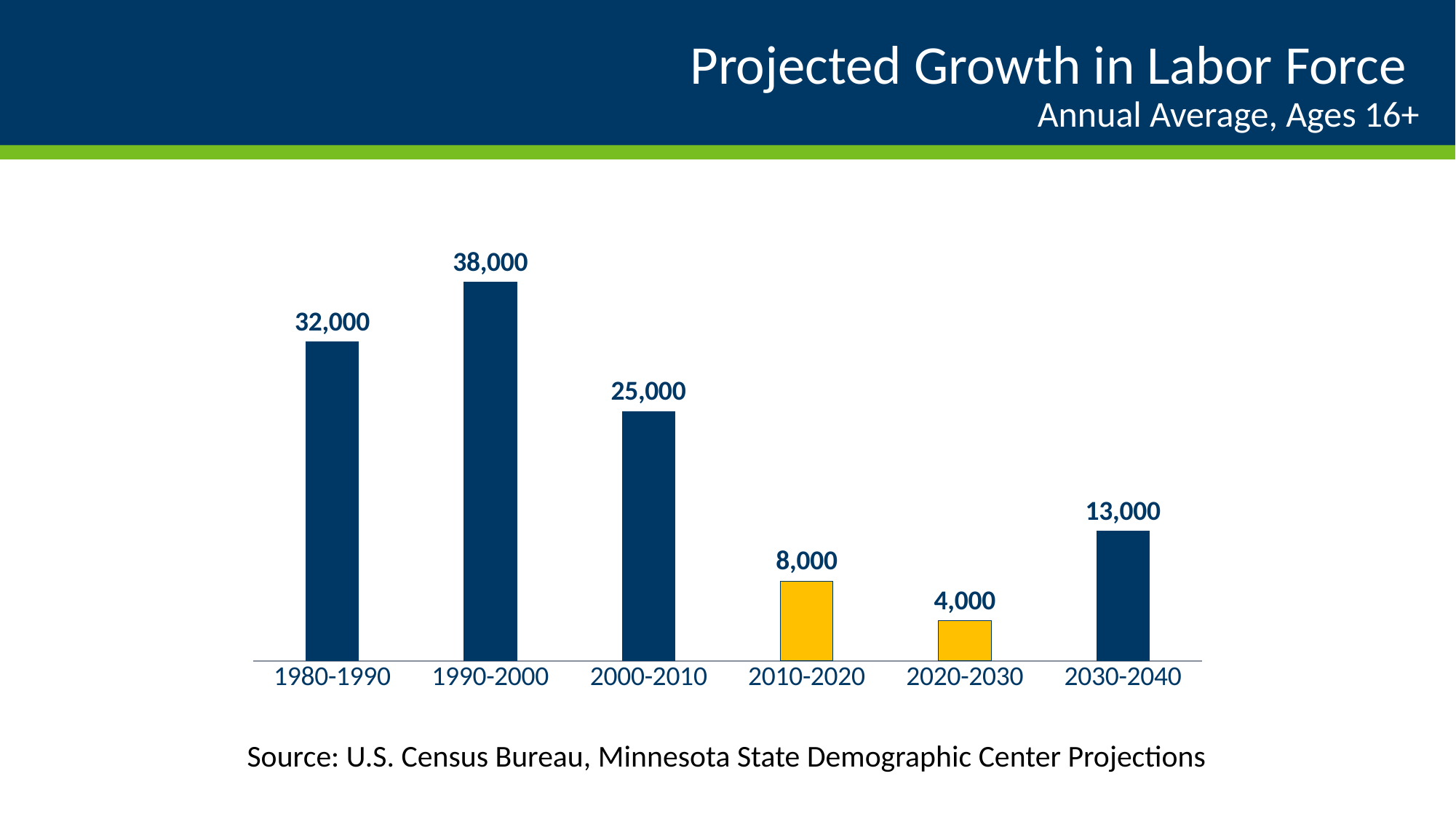
What kind of chart is shown on the slide? Bar chart What is the difference between the values for 2010-2020 and 2020-2030? 4,000 Do the values rise or fall from 1990-2000 to 2020-2030? Fall What is the difference between the values for 1980-1990 and 2000-2010? 7,000 Which is larger, the value for 2030-2040 or the value for 2010-2020? 2030-2040 What is the projected annual average labor force growth for 1990-2000? 38,000 Which period has the highest annual average labor force growth? 1990-2000 What is the value shown for 2030-2040? 13,000 How many time periods are shown on the chart? 6 Which two periods are shown with yellow bars instead of dark blue? 2010-2020 and 2020-2030 What is the value shown for 2020-2030? 4,000 Which period has the lowest annual average labor force growth? 2020-2030